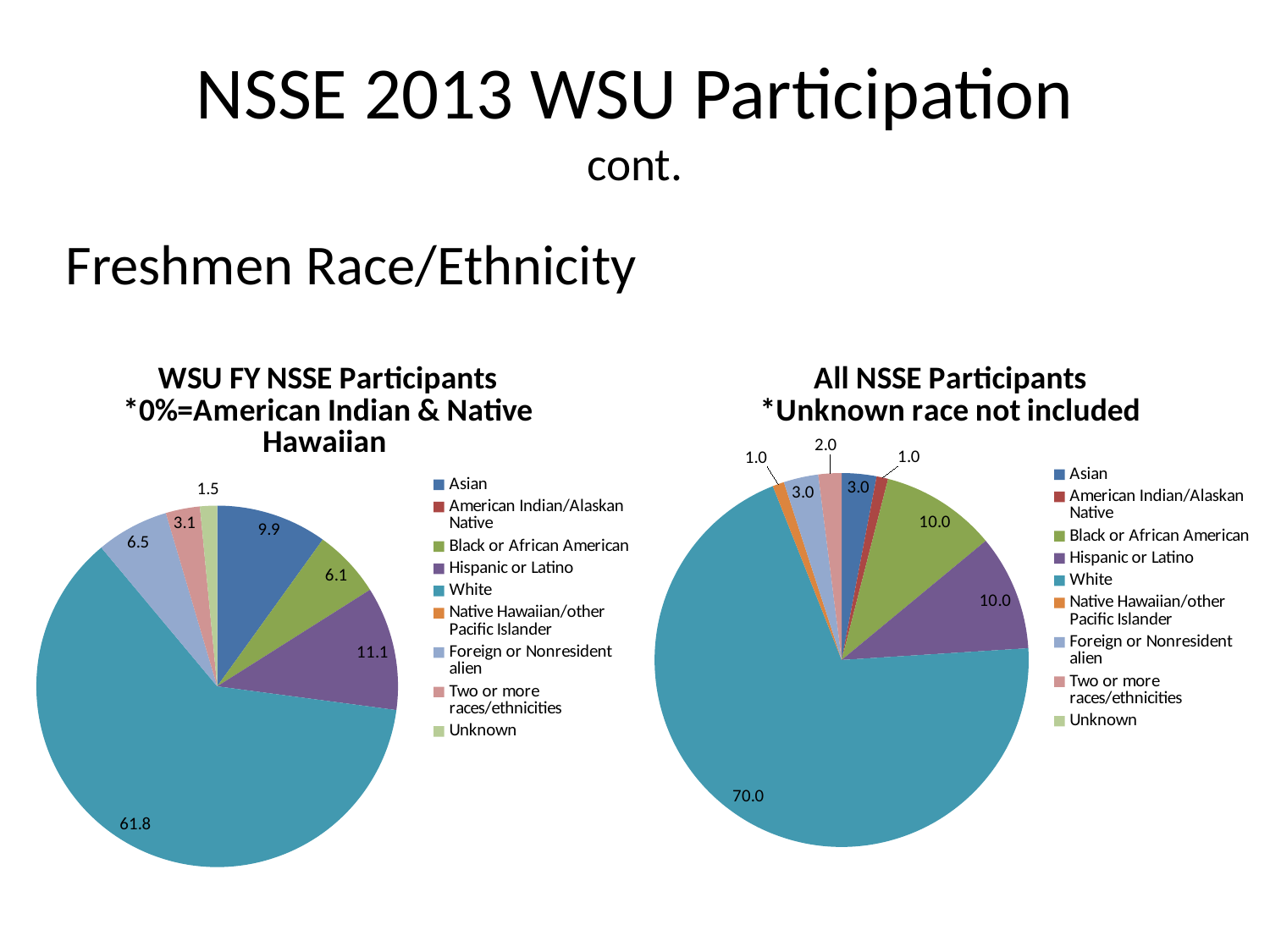
In the All NSSE Participants pie chart, what is the value for Black or African American? 10.0 In the WSU FY NSSE Participants pie chart, what is the value for Hispanic or Latino? 11.1 In the WSU FY NSSE Participants pie chart, which category has the largest slice? White In the All NSSE Participants pie chart, what is the value for White? 70.0 In the WSU FY NSSE Participants pie chart, what is the value for White? 61.8 In the WSU FY NSSE Participants pie chart, which is larger, the value for Foreign or Nonresident alien or the value for Black or African American? Foreign or Nonresident alien In the WSU FY NSSE Participants pie chart, what is the difference between the Hispanic or Latino value and the Asian value? 1.2 What kind of chart is used for All NSSE Participants? Pie chart In the WSU FY NSSE Participants pie chart, what is the value for Asian? 9.9 In the All NSSE Participants pie chart, what is the difference between the White value and the Hispanic or Latino value? 60.0 In the WSU FY NSSE Participants pie chart, which of the labelled slices is the smallest? Unknown How many entries does the legend of the WSU FY NSSE Participants chart list? 9